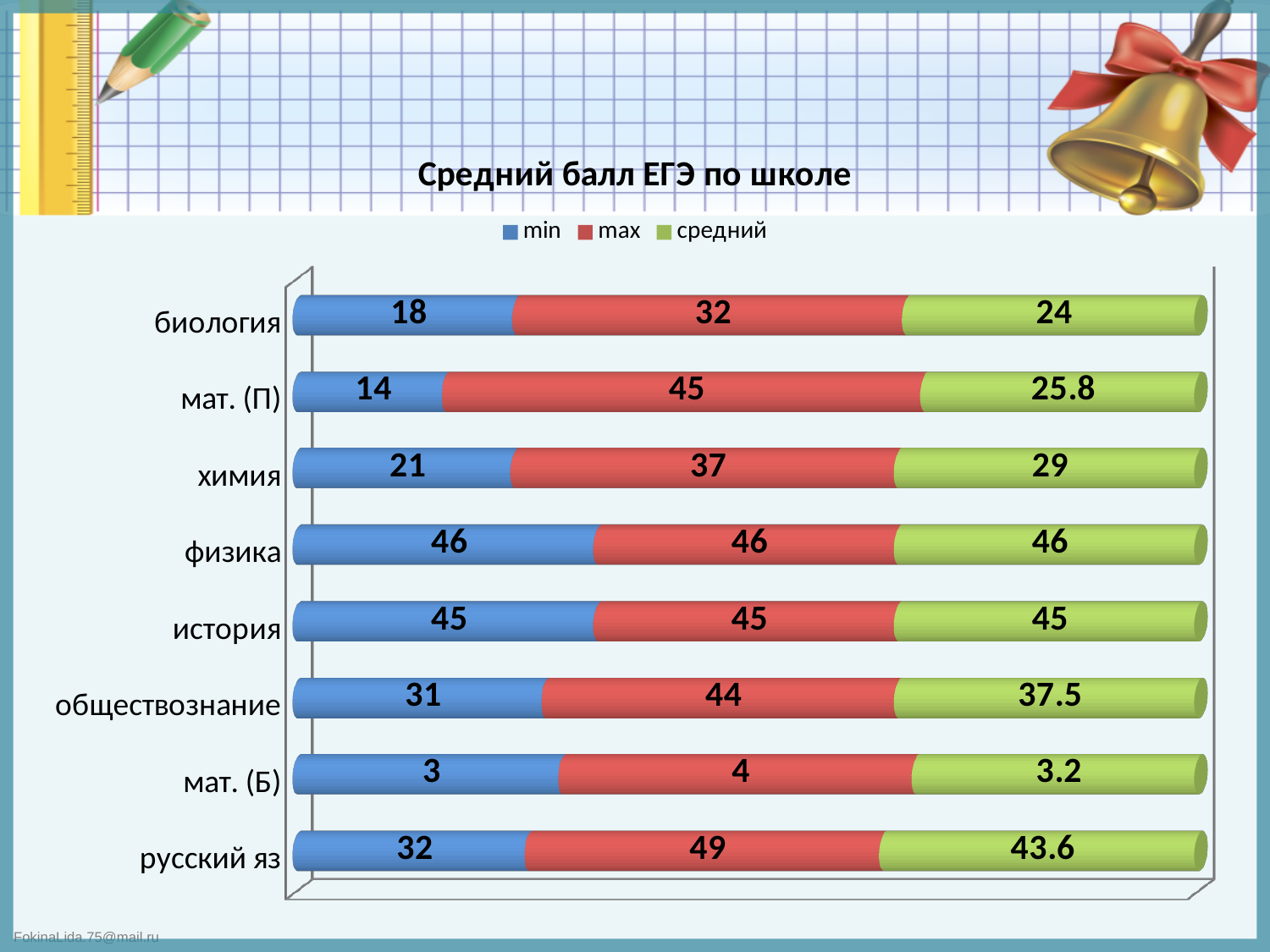
What is the max value for русский яз? 49 Which subject has the lowest min value? мат. (Б) What is the средний value for обществознание? 37.5 What is the title of the chart? Средний балл ЕГЭ по школе Which subject has the highest max value? русский яз What is the difference between the max and min values for химия? 16 Which is larger, the средний value for биология or the средний value for химия? химия What kind of chart is shown on the slide? stacked bar chart How many subjects are shown on the chart? 8 What is the средний value for мат. (Б)? 3.2 What is the min value for мат. (П)? 14 How many series does the legend list? 3